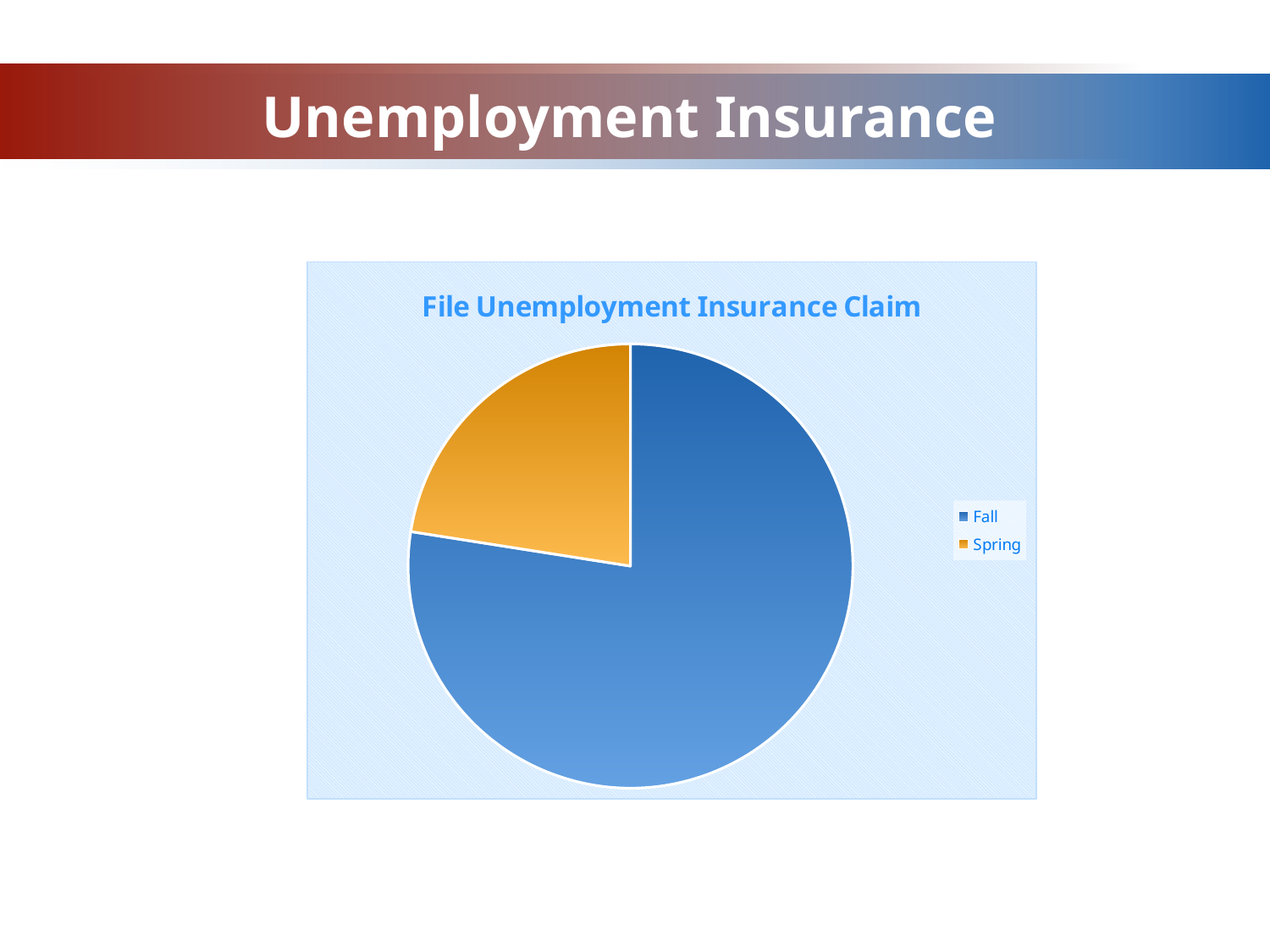
How many slices does the pie chart have? 2 What colour is the Spring slice? orange What kind of chart is shown on the slide? pie chart Which slice is larger, Fall or Spring? Fall What is the title of the chart? File Unemployment Insurance Claim Which category has the largest slice of the pie? Fall Which category has the smallest slice of the pie? Spring How many entries does the legend list? 2